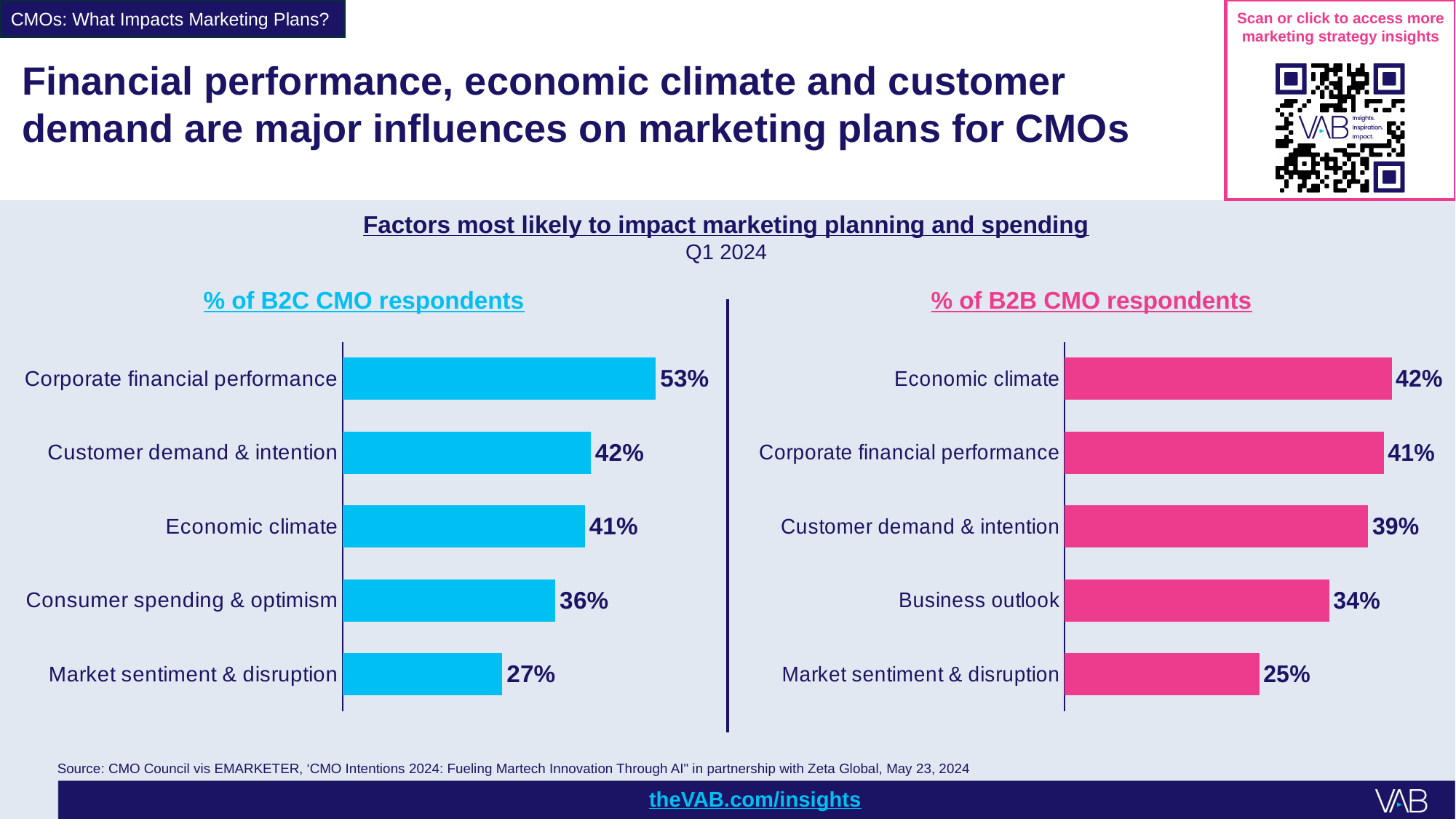
In the '% of B2B CMO respondents' chart, what is the value for Customer demand & intention? 39% In the '% of B2B CMO respondents' chart, what is the difference between Economic climate and Market sentiment & disruption? 17% What kind of chart is the '% of B2C CMO respondents' chart? Bar chart Which is larger: Economic climate in the '% of B2C CMO respondents' chart or Economic climate in the '% of B2B CMO respondents' chart? B2B (42% vs 41%) In the '% of B2B CMO respondents' chart, which category has the highest value? Economic climate In the '% of B2C CMO respondents' chart, which category has the lowest value? Market sentiment & disruption How many categories are shown in the '% of B2B CMO respondents' chart? 5 In the '% of B2C CMO respondents' chart, what is the difference between Corporate financial performance and Customer demand & intention? 11% What colour are the bars in the '% of B2B CMO respondents' chart? Pink In the '% of B2C CMO respondents' chart, what is the value for Corporate financial performance? 53% In the '% of B2B CMO respondents' chart, what is the value for Business outlook? 34% In the '% of B2C CMO respondents' chart, which is larger: Consumer spending & optimism or Market sentiment & disruption? Consumer spending & optimism